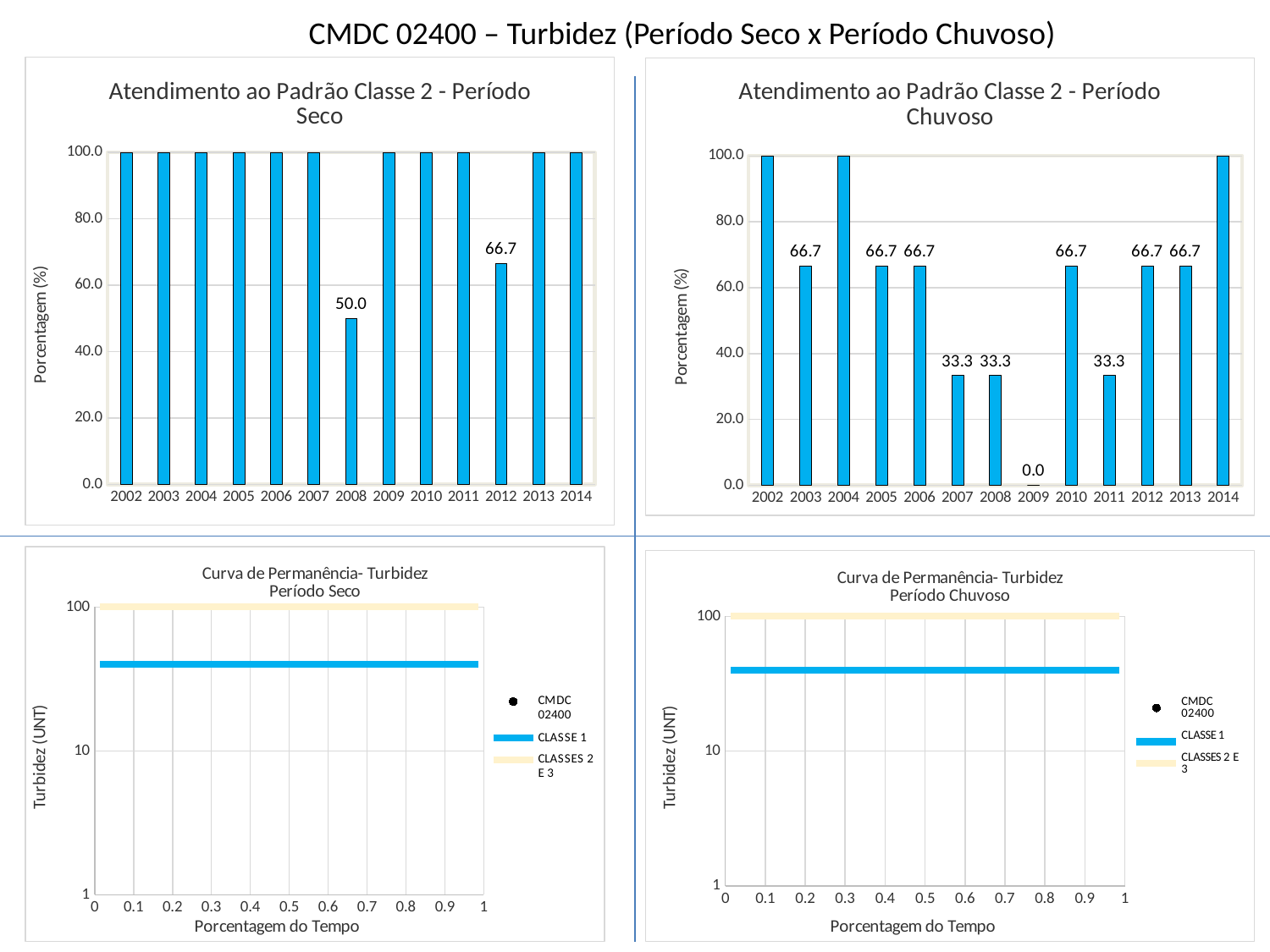
In the 'Atendimento ao Padrão Classe 2 - Período Chuvoso' chart, is the value for 2004 greater or less than 80.0? greater In the 'Atendimento ao Padrão Classe 2 - Período Chuvoso' chart, what is the difference between the values for 2003 and 2011? 33.4 What kind of chart is 'Atendimento ao Padrão Classe 2 - Período Seco'? bar chart How many series does the legend of the 'Curva de Permanência- Turbidez Período Seco' chart list? 3 In the 'Atendimento ao Padrão Classe 2 - Período Chuvoso' chart, what is the value for 2007? 33.3 In the 'Atendimento ao Padrão Classe 2 - Período Seco' chart, how many years are shown on the x axis? 13 In the 'Atendimento ao Padrão Classe 2 - Período Chuvoso' chart, which is larger, the value for 2005 or the value for 2008? 2005 In the 'Atendimento ao Padrão Classe 2 - Período Seco' chart, what is the value for 2008? 50.0 In the 'Atendimento ao Padrão Classe 2 - Período Chuvoso' chart, what is the value for 2009? 0.0 In the 'Atendimento ao Padrão Classe 2 - Período Seco' chart, which year has the lowest value? 2008 In the 'Atendimento ao Padrão Classe 2 - Período Seco' chart, what is the value for 2012? 66.7 In the 'Atendimento ao Padrão Classe 2 - Período Chuvoso' chart, which year has the lowest value? 2009